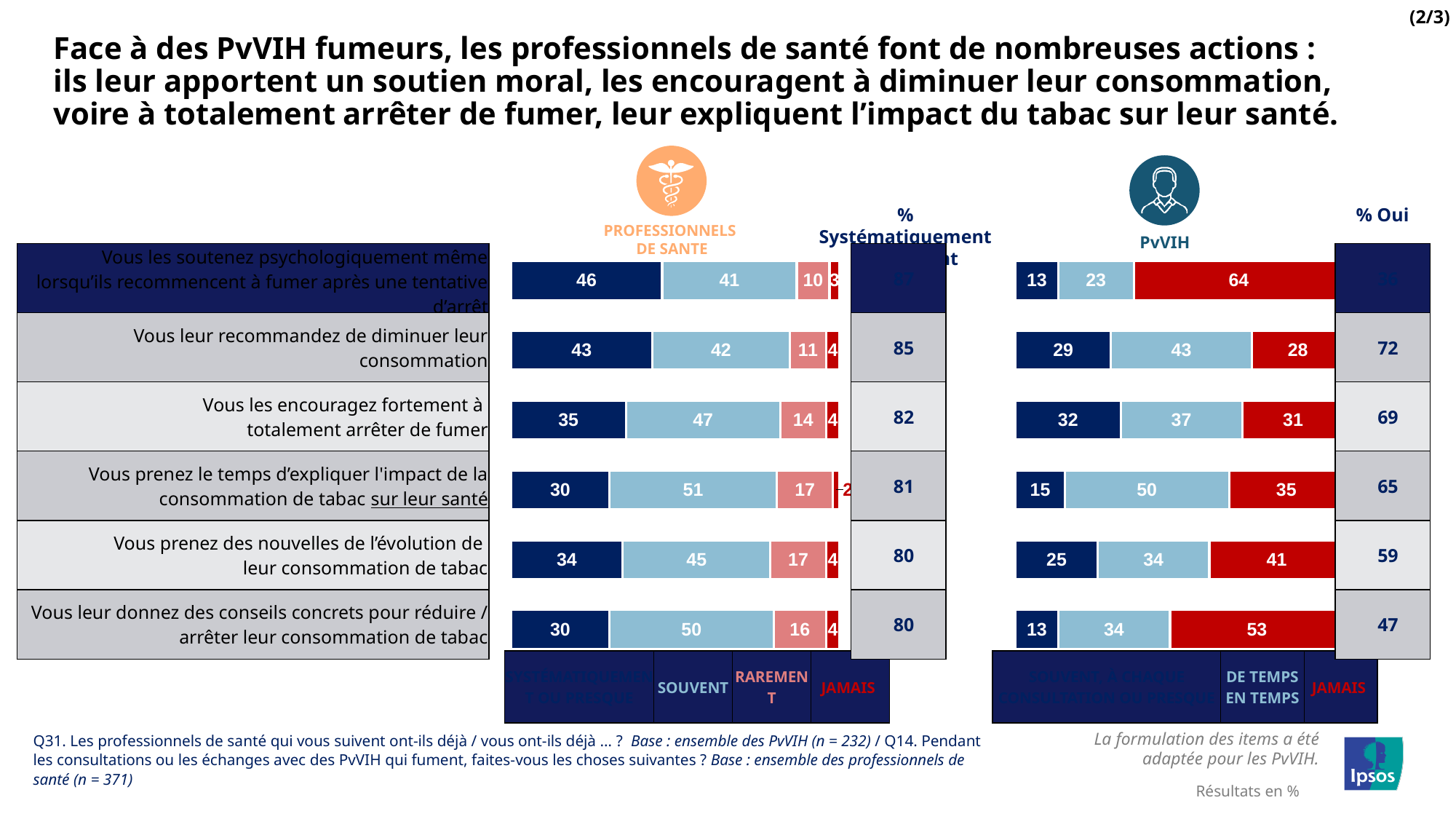
How many series does the legend of the PROFESSIONNELS DE SANTE chart list? 4 In the PvVIH chart, what is the '% Oui' value for 'Vous les encouragez fortement à totalement arrêter de fumer'? 69 In the PvVIH chart, which item has the highest 'Jamais' value? Vous les soutenez psychologiquement même lorsqu'ils recommencent à fumer après une tentative d'arrêt In the PROFESSIONNELS DE SANTE chart, what is the difference between the 'Souvent' value and the first (dark blue) segment value for 'Vous les encouragez fortement à totalement arrêter de fumer'? 12 In the PvVIH chart, what is the total of the stacked bar for 'Vous leur recommandez de diminuer leur consommation'? 100 What kind of chart is the PvVIH chart? Stacked bar chart In the PvVIH chart, what is the 'Jamais' value for 'Vous leur donnez des conseils concrets pour réduire / arrêter leur consommation de tabac'? 53 In the PvVIH chart, which item has the lowest '% Oui' value? Vous leur donnez des conseils concrets pour réduire / arrêter leur consommation de tabac In the PvVIH chart, which is larger for 'Vous prenez des nouvelles de l'évolution de leur consommation de tabac': the 'De temps en temps' value or the 'Jamais' value? Jamais In the PROFESSIONNELS DE SANTE chart, what is the 'Souvent' value for 'Vous prenez le temps d'expliquer l'impact de la consommation de tabac sur leur santé'? 51 In the PROFESSIONNELS DE SANTE chart, what is the '% Systématiquement + Souvent' value for 'Vous leur recommandez de diminuer leur consommation'? 85 How many items (categories) are shown in the PROFESSIONNELS DE SANTE chart? 6